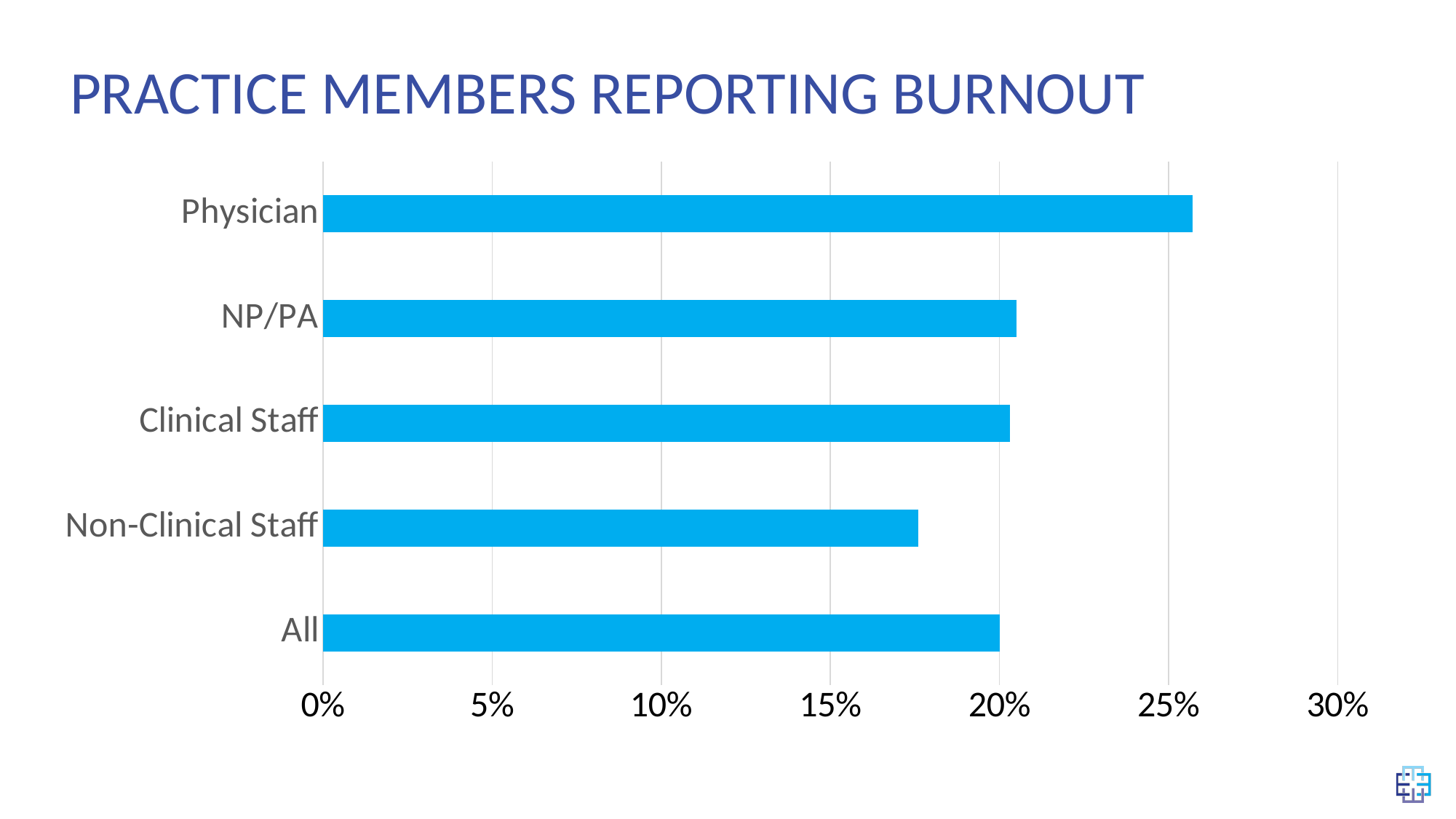
Is the value for Physician greater or less than 25%? greater Which is larger, the value for Physician or the value for NP/PA? Physician Is the value for Non-Clinical Staff greater or less than 20%? less What type of chart is shown on the slide? Bar chart Which is larger, the value for Non-Clinical Staff or the value for All? All How many categories are shown on the chart? 5 Is the value for Non-Clinical Staff greater or less than 15%? greater Which category has the highest percentage reporting burnout? Physician Which category has the lowest percentage reporting burnout? Non-Clinical Staff What is the title of the chart? PRACTICE MEMBERS REPORTING BURNOUT What colour are the bars in the chart? Blue